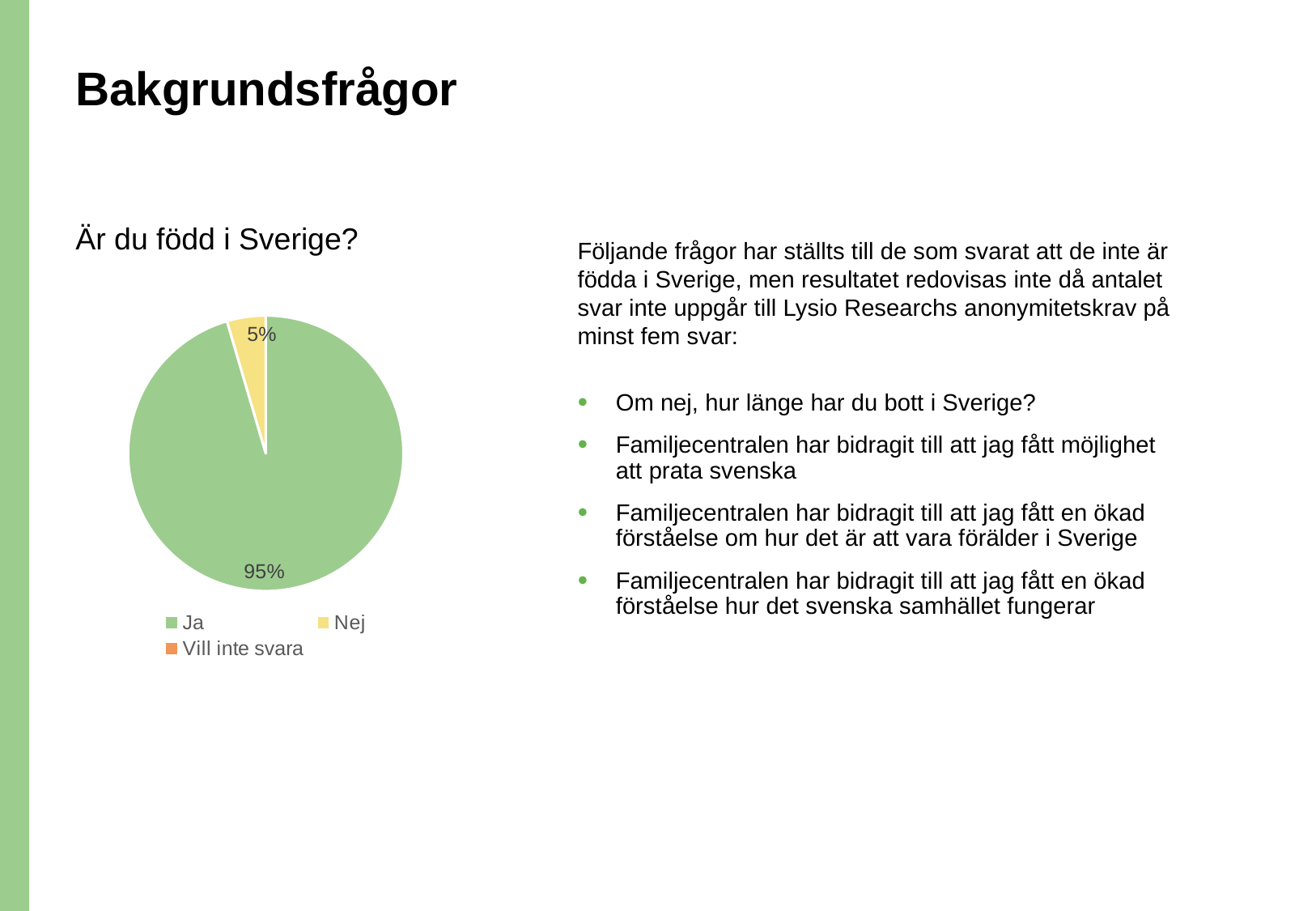
How many entries does the chart legend list? 3 What share of the pie does "Nej" take? 5% What is the title of the chart? Är du född i Sverige? What is the difference in percentage points between the "Ja" and "Nej" slices? 90 Which legend entry is shown in orange? Vill inte svara What share of the pie does "Ja" take? 95% Which of the two labelled slices is larger, "Ja" or "Nej"? Ja Which category has the largest slice of the pie? Ja Is the share for "Ja" greater or less than 50%? greater What kind of chart is shown on the slide? Pie chart